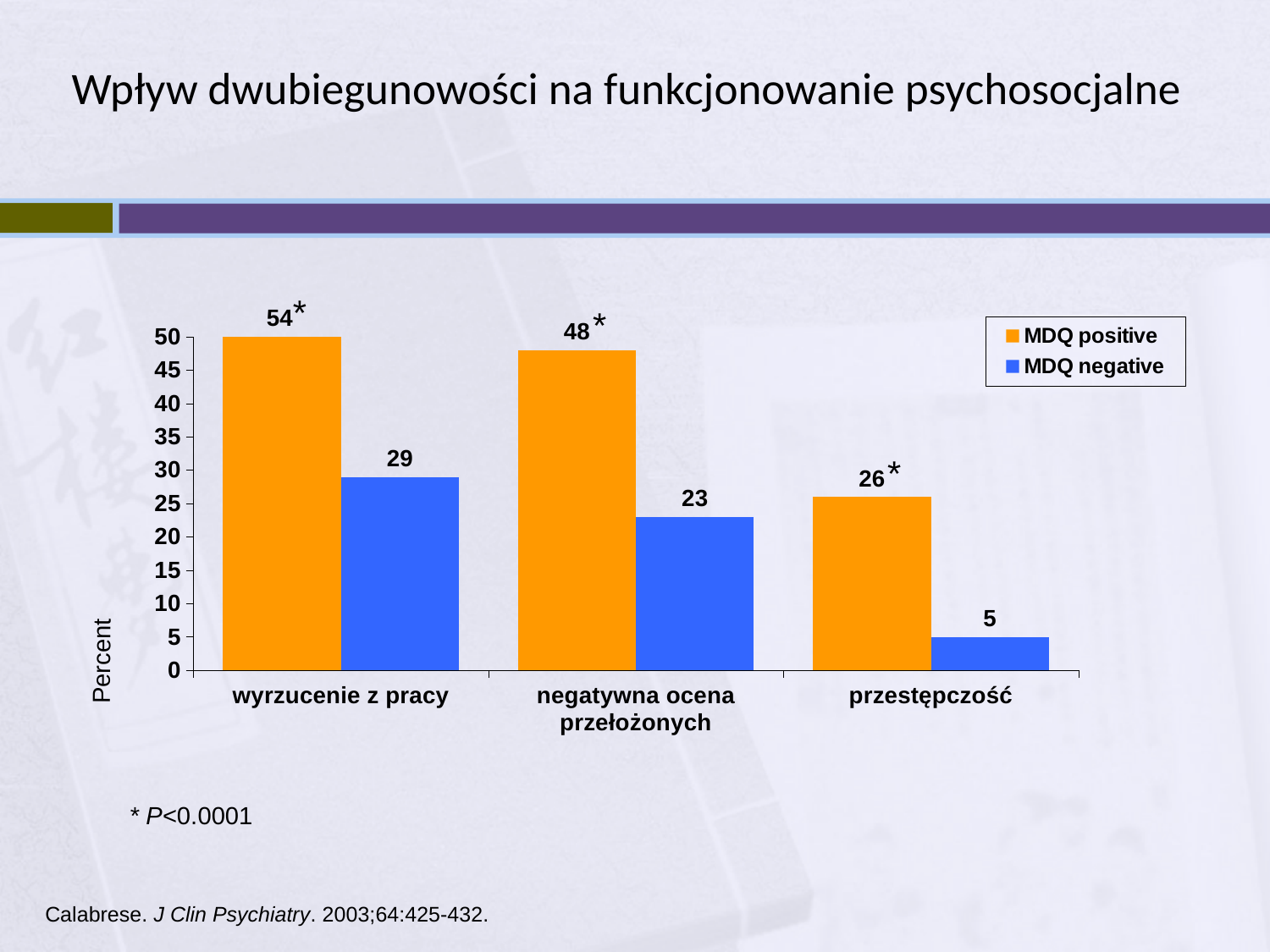
How many categories are shown on the x axis? 3 How many series does the legend list? 2 Which category has the lowest MDQ negative value? przestępczość What kind of chart is shown on the slide? bar chart What is the MDQ negative value for przestępczość? 5 Which is larger for negatywna ocena przełożonych: MDQ positive or MDQ negative? MDQ positive What is the difference between the MDQ positive and MDQ negative values for przestępczość? 21 What is the difference between the MDQ positive and MDQ negative values for wyrzucenie z pracy? 25 Which category has the highest MDQ positive value? wyrzucenie z pracy What is the MDQ positive value for wyrzucenie z pracy? 54 What is the MDQ negative value for negatywna ocena przełożonych? 23 What is the label of the y axis? Percent